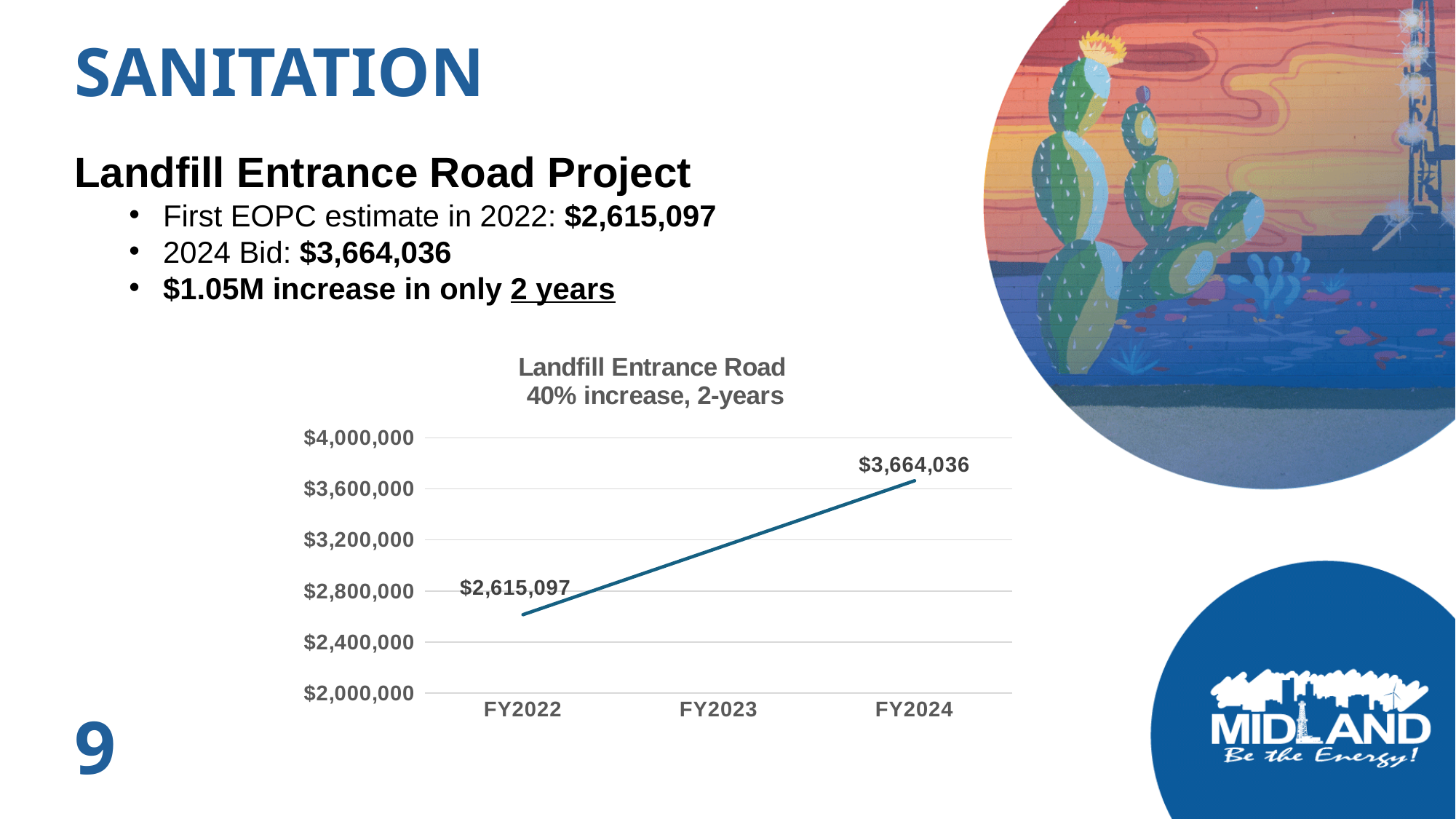
Which fiscal year has the higher value on the chart, FY2022 or FY2024? FY2024 What value does the chart show for FY2022? $2,615,097 Is the value for FY2024 greater or less than $3,600,000? greater What is the difference between the FY2024 value and the FY2022 value on the chart? $1,048,939 Does the line on the chart rise or fall from FY2022 to FY2024? rise How many data points are labeled with values on the chart? 2 What value does the chart show for FY2024? $3,664,036 What is the highest value shown on the chart's vertical axis? $4,000,000 Which plotted point on the chart has the lowest value? FY2022 What is the title of the chart? Landfill Entrance Road 40% increase, 2-years Is the value for FY2022 greater or less than $2,800,000? less What kind of chart is shown on the slide? line chart